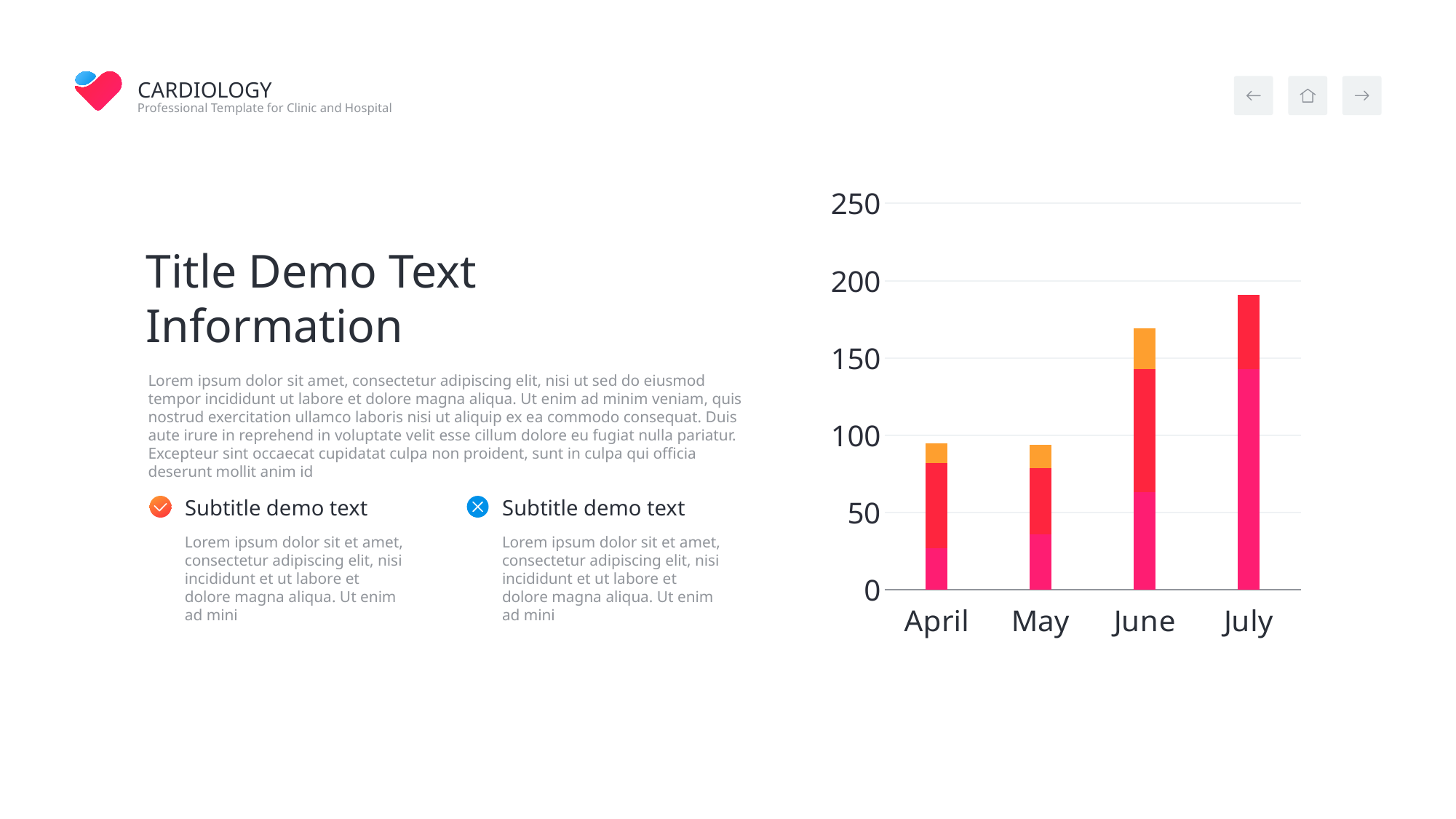
Is the total bar for June greater or less than 150? greater Do the bar totals generally rise or fall from April to July? rise Is the total bar for May greater or less than 50? greater What kind of chart is shown on the slide? Stacked bar chart How many months are shown on the x axis of the chart? 4 Which bar is taller, May or June? June What is the highest value shown on the chart's vertical axis? 250 Is the total bar for July greater or less than 150? greater Which bar is taller, June or July? July Which month has the tallest bar in the chart? July